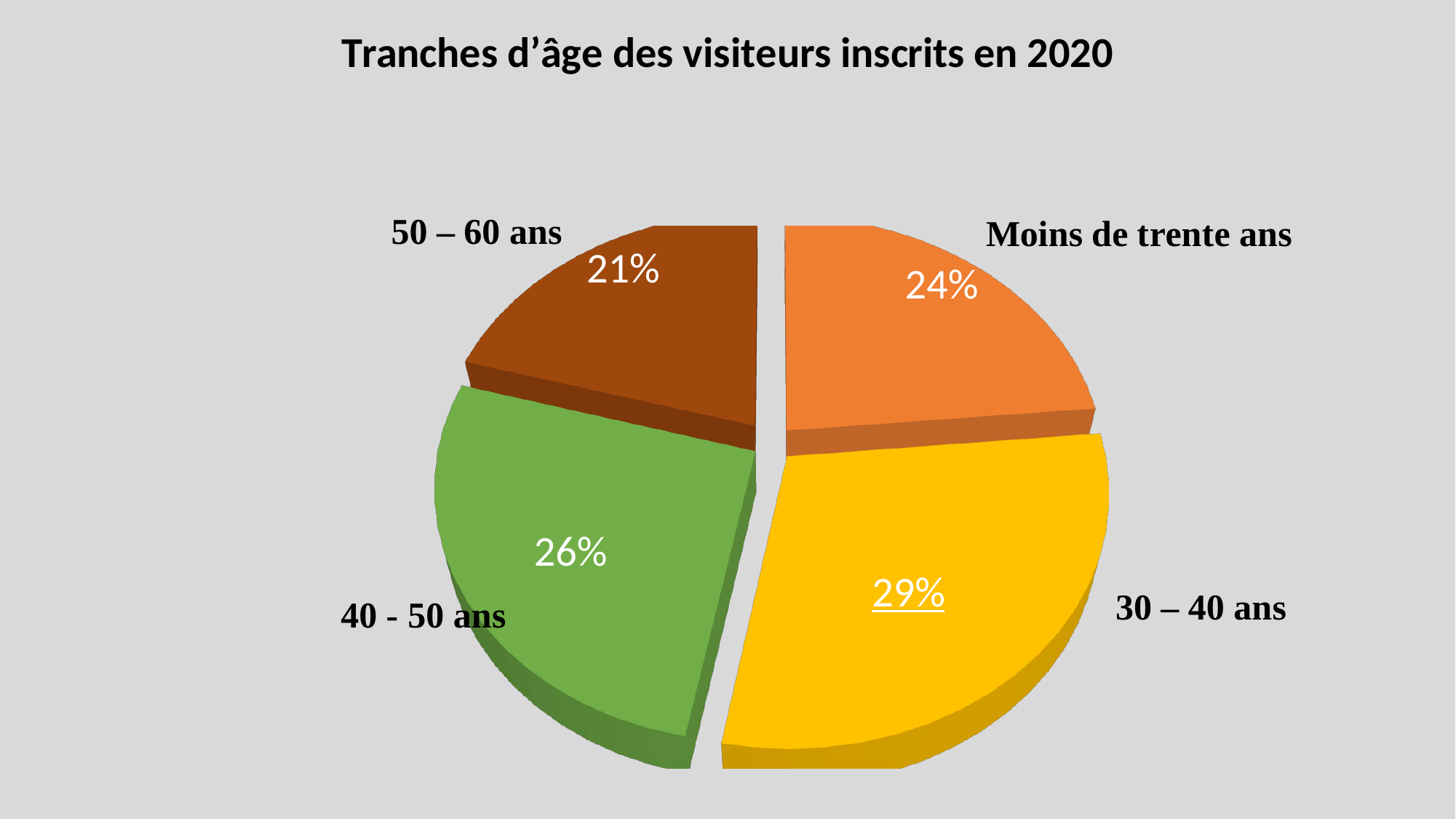
Which slice is larger, '40 - 50 ans' or 'Moins de trente ans'? 40 - 50 ans What is the difference in percentage points between the '40 - 50 ans' slice and the 'Moins de trente ans' slice? 2 Which age group has the smallest slice of the pie? 50 – 60 ans What share of the pie does the '50 – 60 ans' slice represent? 21% How many age groups are shown in the pie chart? 4 What kind of chart is shown on the slide? Pie chart What share of the pie does the 'Moins de trente ans' slice represent? 24% What is the title of the chart? Tranches d’âge des visiteurs inscrits en 2020 What share of the pie does the '30 – 40 ans' slice represent? 29% What is the difference in percentage points between the '30 – 40 ans' slice and the '50 – 60 ans' slice? 8 Which age group has the largest slice of the pie? 30 – 40 ans